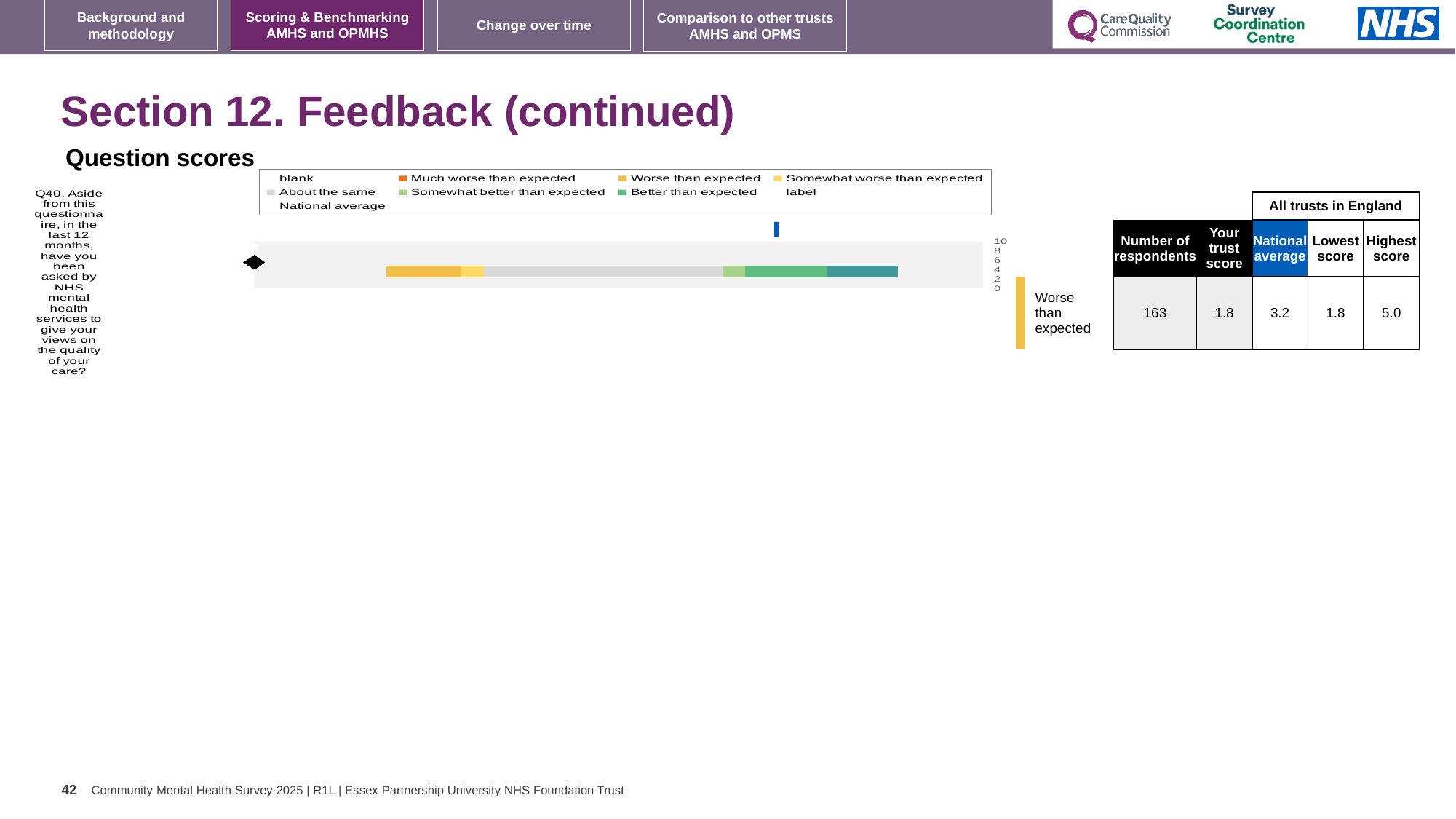
In the table beside the chart, which is larger for Q40: the trust score or the national average? national average What rating label is printed to the right of the bar chart for Q40? Worse than expected In the table beside the chart, what is the difference between the national average and the trust score for Q40? 1.4 What kind of chart is shown under 'Question scores'? bar chart Which question number does the bar chart under 'Question scores' relate to? Q40 In the table beside the chart, what is the lowest score among all trusts in England for Q40? 1.8 In the table beside the chart, what is the difference between the highest and lowest scores for Q40? 3.2 In the table beside the chart, what is the national average for Q40? 3.2 In the table beside the chart, what is the number of respondents for Q40? 163 In the table beside the chart, what is the highest score among all trusts in England for Q40? 5.0 In the table beside the chart, what is 'Your trust score' for Q40? 1.8